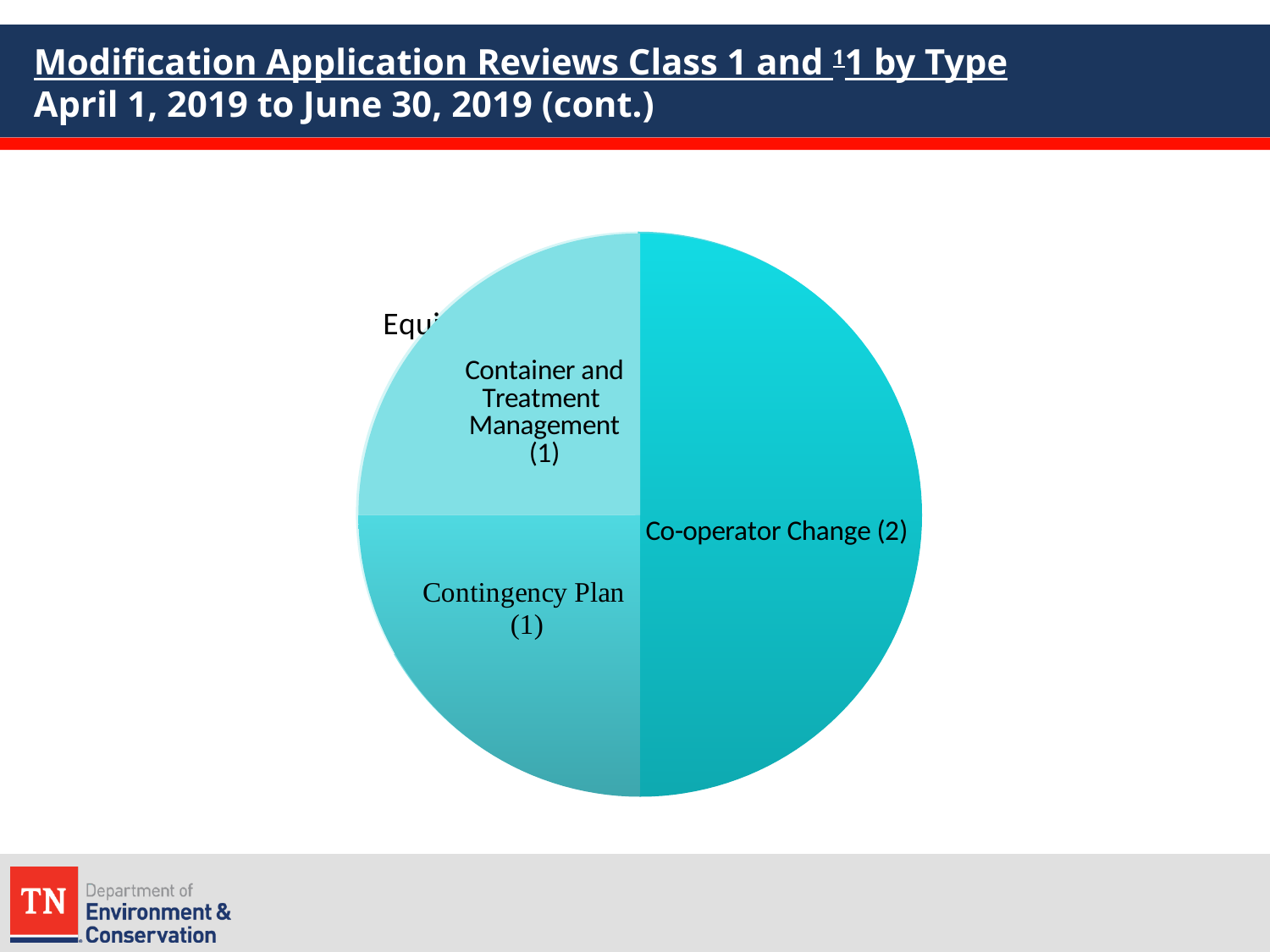
What is the total of the values shown in the pie chart? 4 What is the value for Container and Treatment Management? 1 What kind of chart is shown on the slide? pie chart What is the value for Contingency Plan? 1 What share of the pie does Contingency Plan represent? 25% What date range does the slide title give for the modification application reviews? April 1, 2019 to June 30, 2019 What is the difference between the values for Co-operator Change and Container and Treatment Management? 1 Which category has the largest slice of the pie? Co-operator Change What share of the pie does Co-operator Change represent? 50% What is the value for Co-operator Change? 2 Which is larger, Co-operator Change or Contingency Plan? Co-operator Change